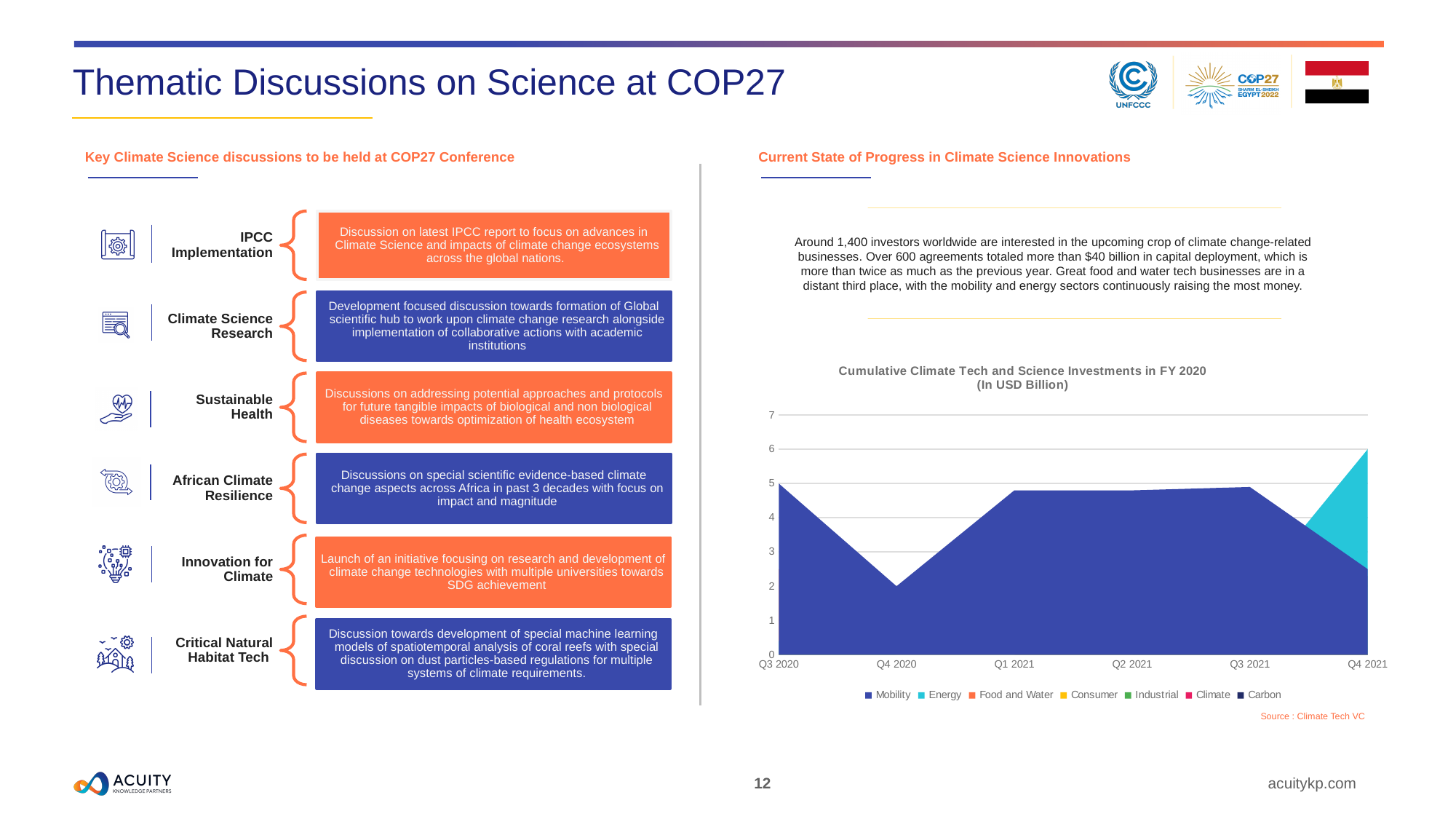
How many quarters are shown on the x axis of the chart? 6 Does the Mobility value rise or fall from Q3 2020 to Q4 2020? fall Is the Mobility value for Q4 2020 greater or less than 3? less What kind of chart is shown on the slide? Area chart What is the source cited for the chart? Climate Tech VC How many series does the legend of the chart list? 7 Is the Mobility value for Q3 2020 greater or less than 4? greater What is the title of the chart? Cumulative Climate Tech and Science Investments in FY 2020 (In USD Billion) Which quarter has the larger Mobility value, Q3 2020 or Q4 2020? Q3 2020 In which quarter is the Mobility value lowest? Q4 2020